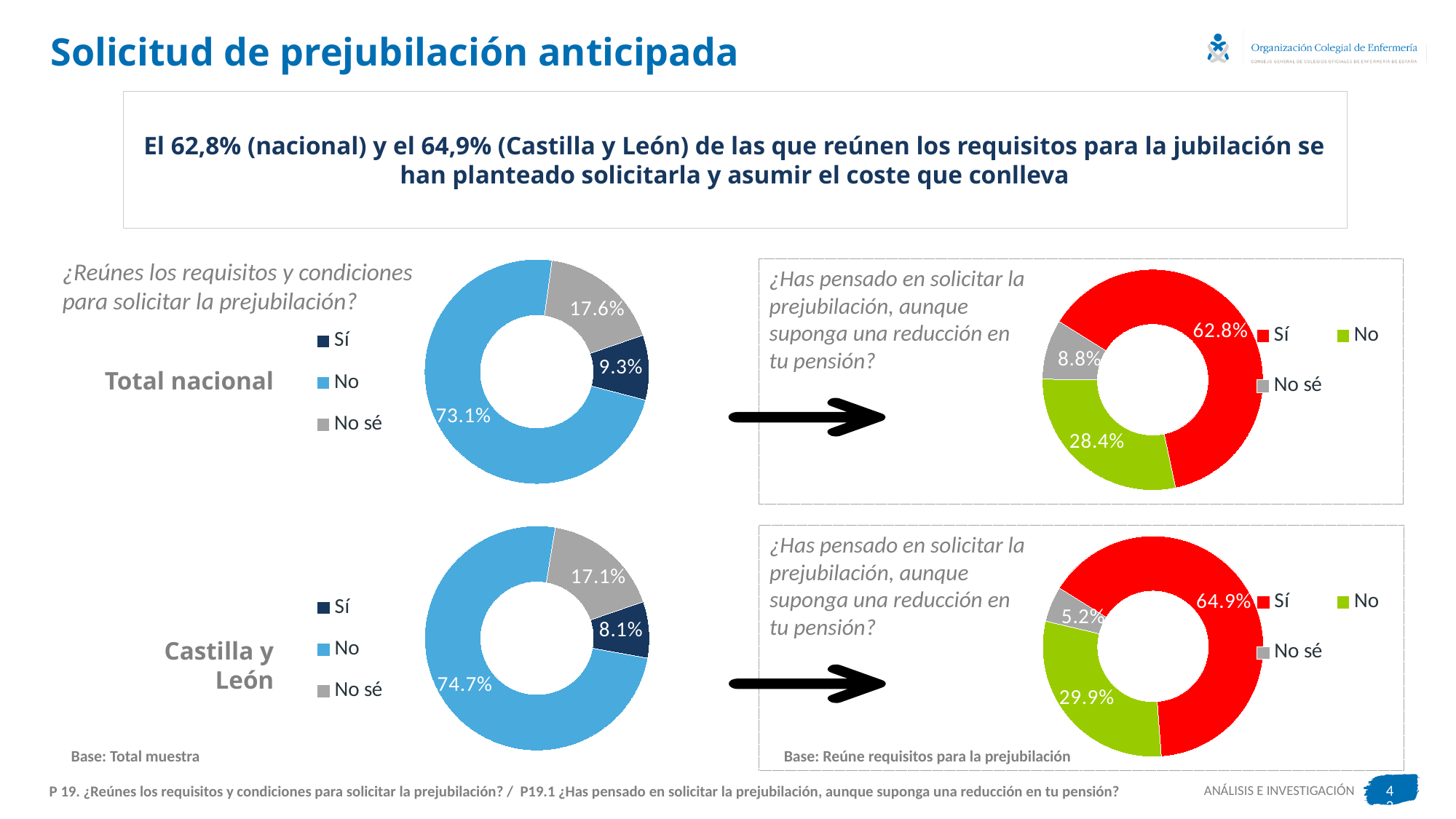
Comparing the Sí values in the two right-hand donut charts (¿Has pensado en solicitar la prejubilación?), which is larger: Total nacional or Castilla y León? Castilla y León What type of chart is used for the Castilla y León ¿Has pensado en solicitar la prejubilación? data at the bottom right? Donut chart How many categories does the top-left donut chart (Total nacional, requisitos para la prejubilación) show? 3 In the top-right donut chart (Total nacional, ¿Has pensado en solicitar la prejubilación?), what is the value for No sé? 8.8% In the top-left donut chart (Total nacional, ¿Reúnes los requisitos y condiciones para solicitar la prejubilación?), what is the value for No? 73.1% In the bottom-left donut chart (Castilla y León, requisitos para la prejubilación), which category has the smallest share? Sí In the bottom-right donut chart (Castilla y León, ¿Has pensado en solicitar la prejubilación?), what is the value for No? 29.9% In the bottom-right donut chart (Castilla y León, ¿Has pensado en solicitar la prejubilación?), what is the difference between Sí and No? 35.0% In the top-right donut chart (Total nacional, ¿Has pensado en solicitar la prejubilación?), what colour represents Sí? Red In the top-right donut chart (Total nacional, ¿Has pensado en solicitar la prejubilación?), which category has the largest share? Sí In the bottom-left donut chart (Castilla y León, requisitos para la prejubilación), what is the value for No sé? 17.1% In the top-left donut chart (Total nacional, requisitos para la prejubilación), what is the value for Sí? 9.3%